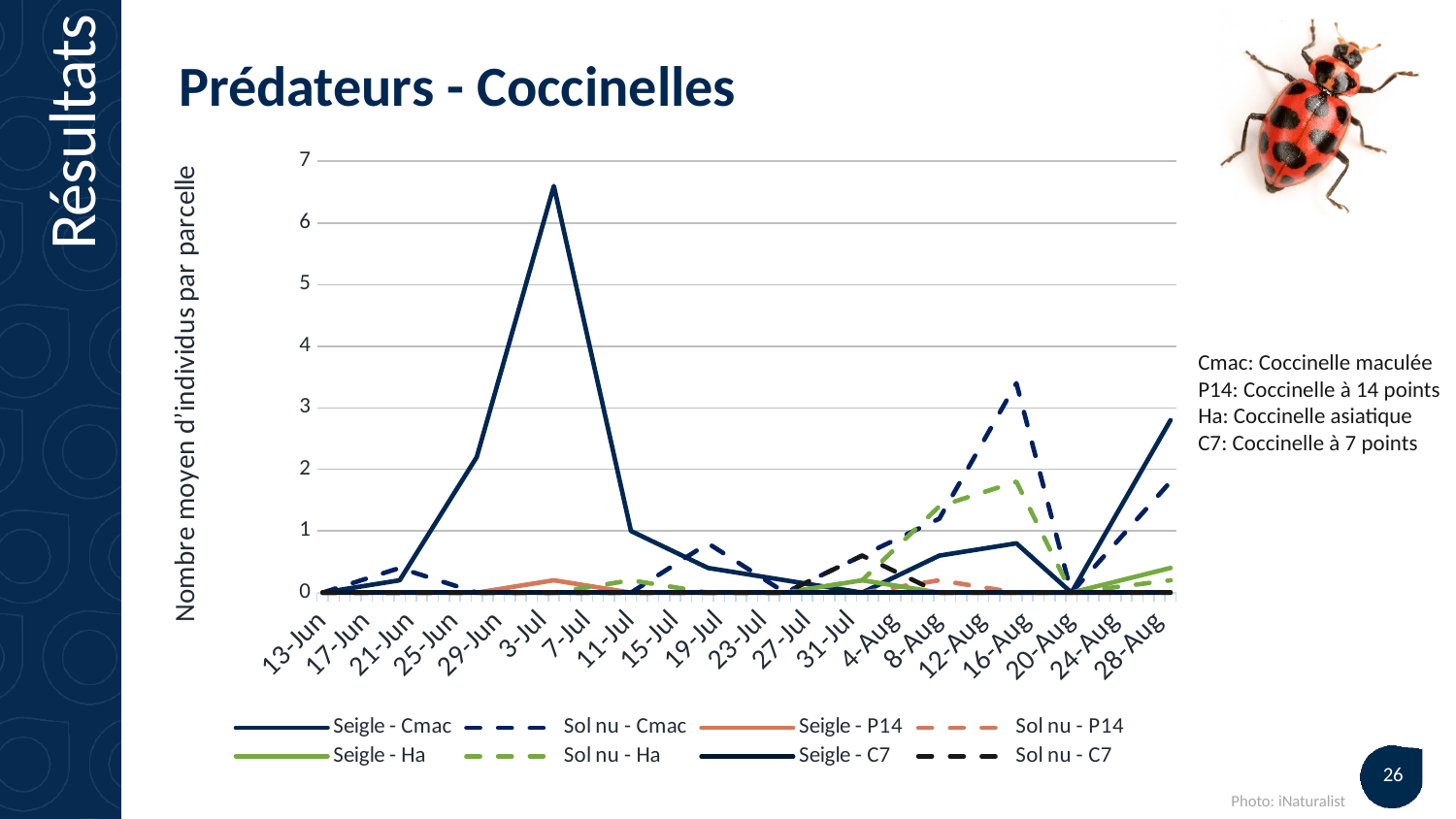
Is the value for Sol nu - Cmac at 16-Aug greater or less than 3? greater How many dates are shown along the x axis of the chart? 20 What is the first date shown on the x axis of the chart? 13-Jun What is the highest tick value shown on the vertical axis? 7 On which date does the highest value on the chart occur? 3-Jul How many series does the chart legend list? 8 What kind of chart is shown on the slide? Line chart Does the Sol nu - Cmac line rise or fall between 16-Aug and 20-Aug? Fall Is the highest value on the chart (at 3-Jul) greater or less than 6? greater Is the value for Sol nu - Ha at 16-Aug greater or less than 1? greater At 16-Aug, which is larger: Sol nu - Cmac or Sol nu - Ha? Sol nu - Cmac What is the label of the vertical axis of the chart? Nombre moyen d'individus par parcelle